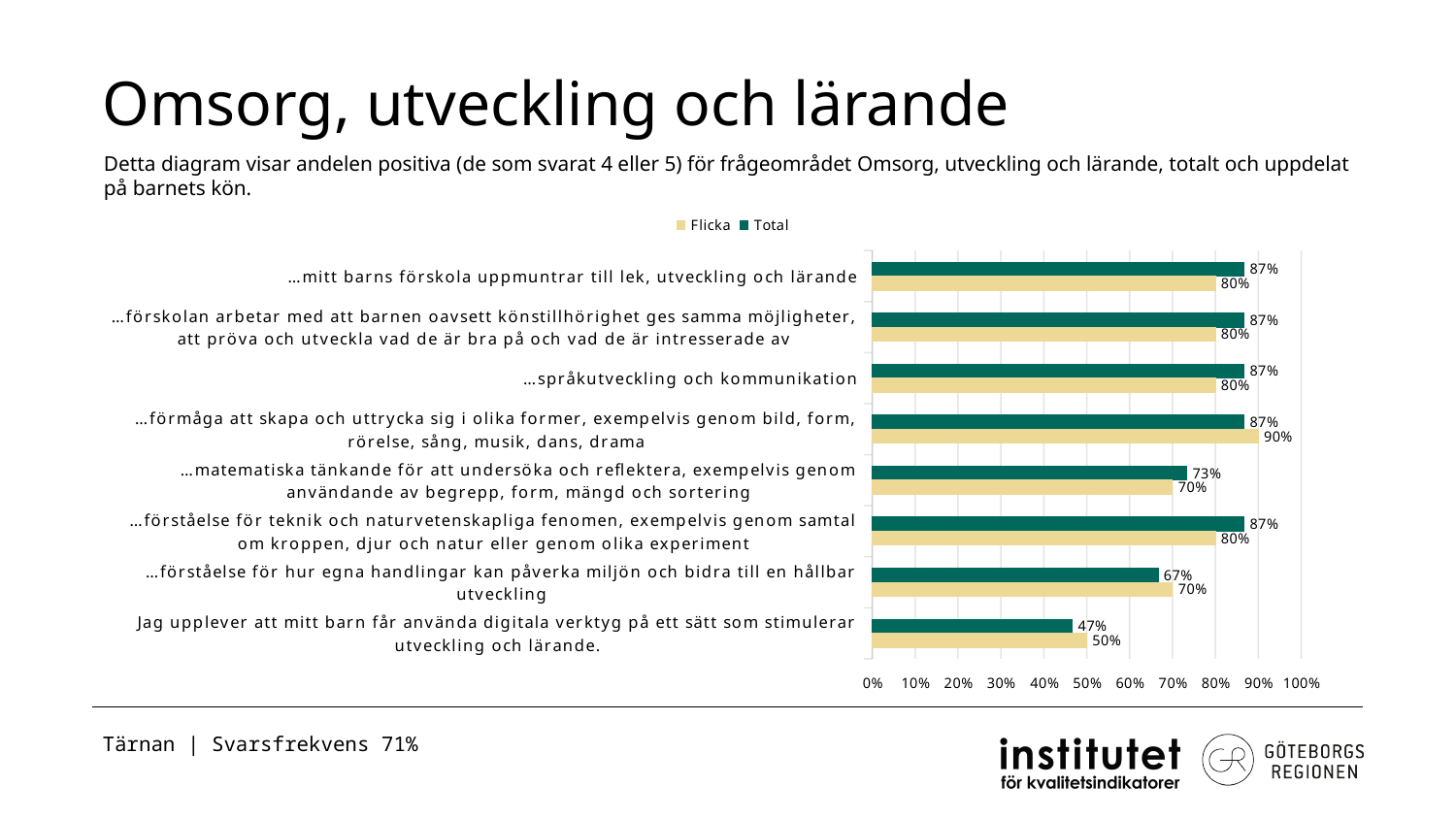
How many series does the legend list? 2 What is the Flicka value for "…matematiska tänkande för att undersöka och reflektera, exempelvis genom användande av begrepp, form, mängd och sortering"? 70% What is the difference between the Total and Flicka values for "…mitt barns förskola uppmuntrar till lek, utveckling och lärande"? 7 percentage points Which series is shown in green in the chart? Total How many categories are shown in the chart? 8 What is the Flicka value for "…förmåga att skapa och uttrycka sig i olika former, exempelvis genom bild, form, rörelse, sång, musik, dans, drama"? 90% For "…förståelse för hur egna handlingar kan påverka miljön och bidra till en hållbar utveckling", which is larger, the Flicka value or the Total value? Flicka Which category has the lowest Total value? Jag upplever att mitt barn får använda digitala verktyg på ett sätt som stimulerar utveckling och lärande. What is the Total value for "…språkutveckling och kommunikation"? 87% Which category has the highest Flicka value? …förmåga att skapa och uttrycka sig i olika former, exempelvis genom bild, form, rörelse, sång, musik, dans, drama What kind of chart is shown on the slide? Bar chart What is the Total value for "Jag upplever att mitt barn får använda digitala verktyg på ett sätt som stimulerar utveckling och lärande."? 47%